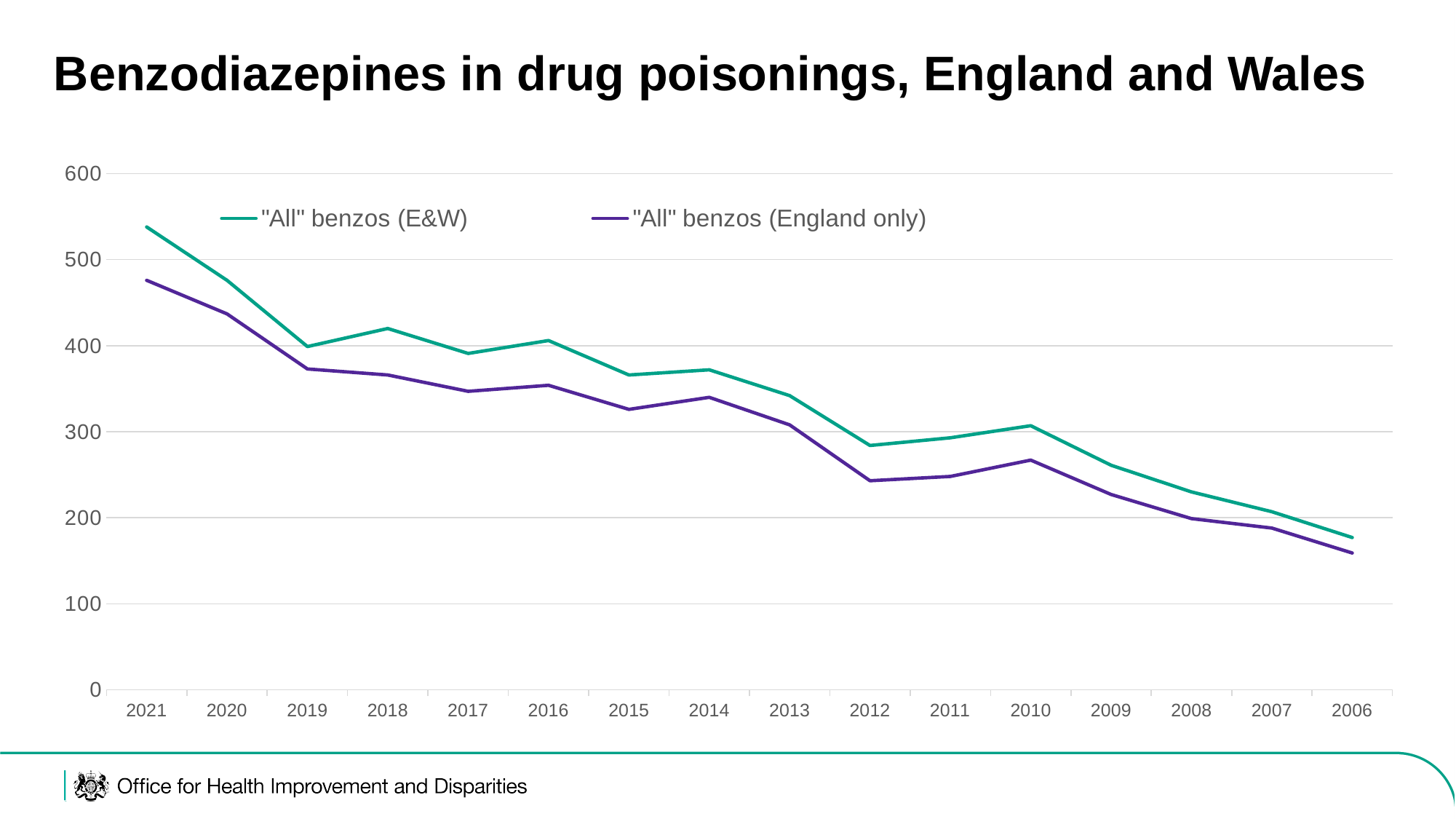
In which year is the "All" benzos (E&W) series at its highest? 2021 How many series does the legend list? 2 What kind of chart is shown on the slide? Line chart How many years are shown on the x axis? 16 Is the value for "All" benzos (England only) in 2021 greater or less than 500? less Is the value for "All" benzos (England only) in 2012 greater or less than 300? less Moving from left to right along the x axis (2021 to 2006), do the values of the "All" benzos (E&W) series generally rise or fall? Fall Which series has the larger value in 2021, "All" benzos (E&W) or "All" benzos (England only)? "All" benzos (E&W) Is the value for "All" benzos (E&W) in 2021 greater or less than 500? greater In which year is the "All" benzos (England only) series at its lowest? 2006